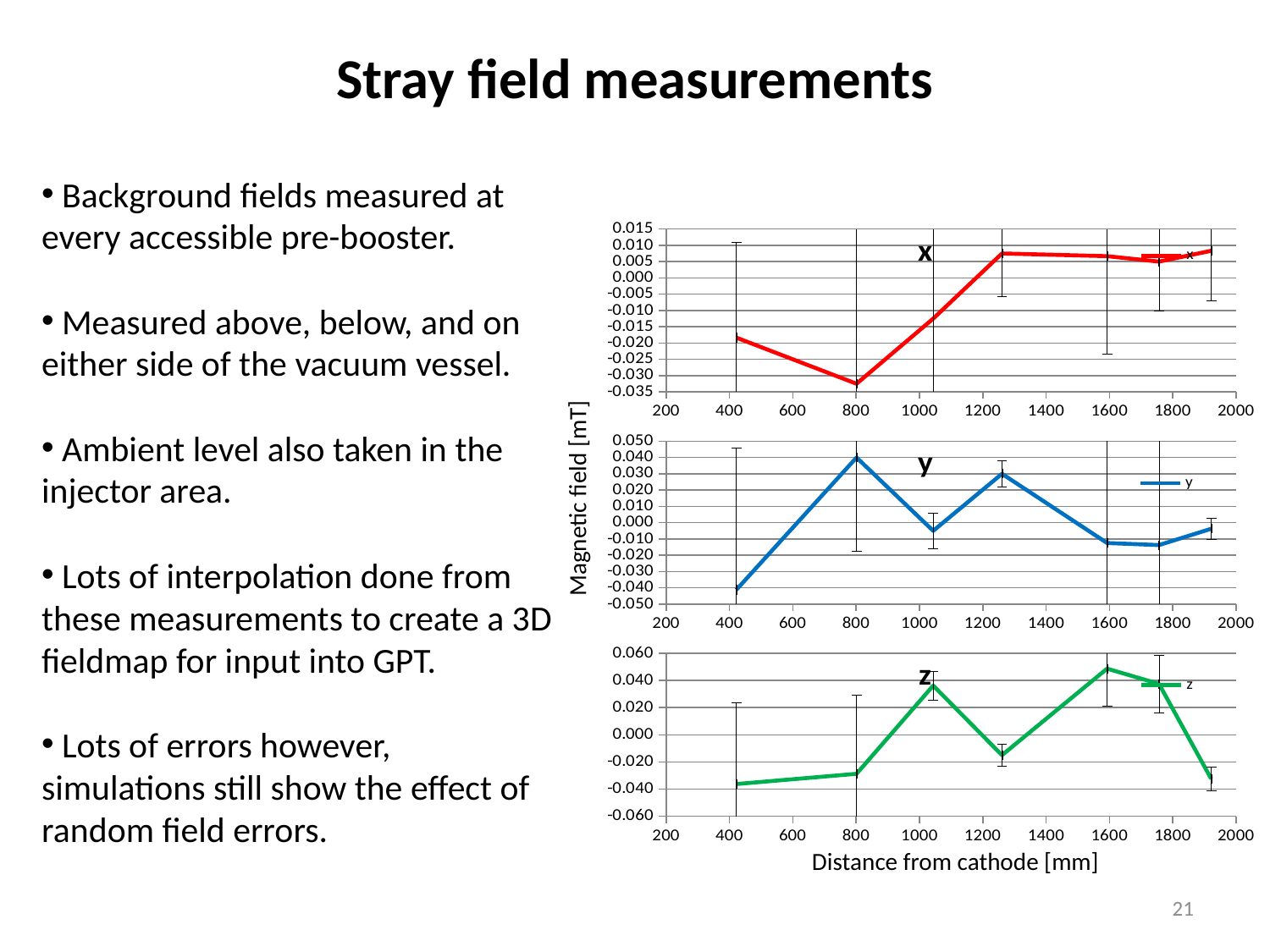
What kind of chart is the top chart labelled x? line chart In the bottom chart labelled z, at which distance from the cathode is the magnetic field highest? 1600 In the top chart labelled x, is the value at 800 mm greater or less than -0.020? less How many series does the legend of the middle chart labelled y list? 1 What is the label on the shared horizontal axis of the charts? Distance from cathode [mm] In the top chart labelled x, at which distance from the cathode is the magnetic field lowest? 800 In the middle chart labelled y, is the value at 800 mm greater or less than 0.030? greater In the top chart labelled x, does the magnetic field rise or fall between 800 mm and 1200 mm? rise How many data points are plotted in the bottom chart labelled z? 7 In the middle chart labelled y, at which distance from the cathode is the magnetic field highest? 800 In the bottom chart labelled z, is the value at 1200 mm greater or less than 0.000? less